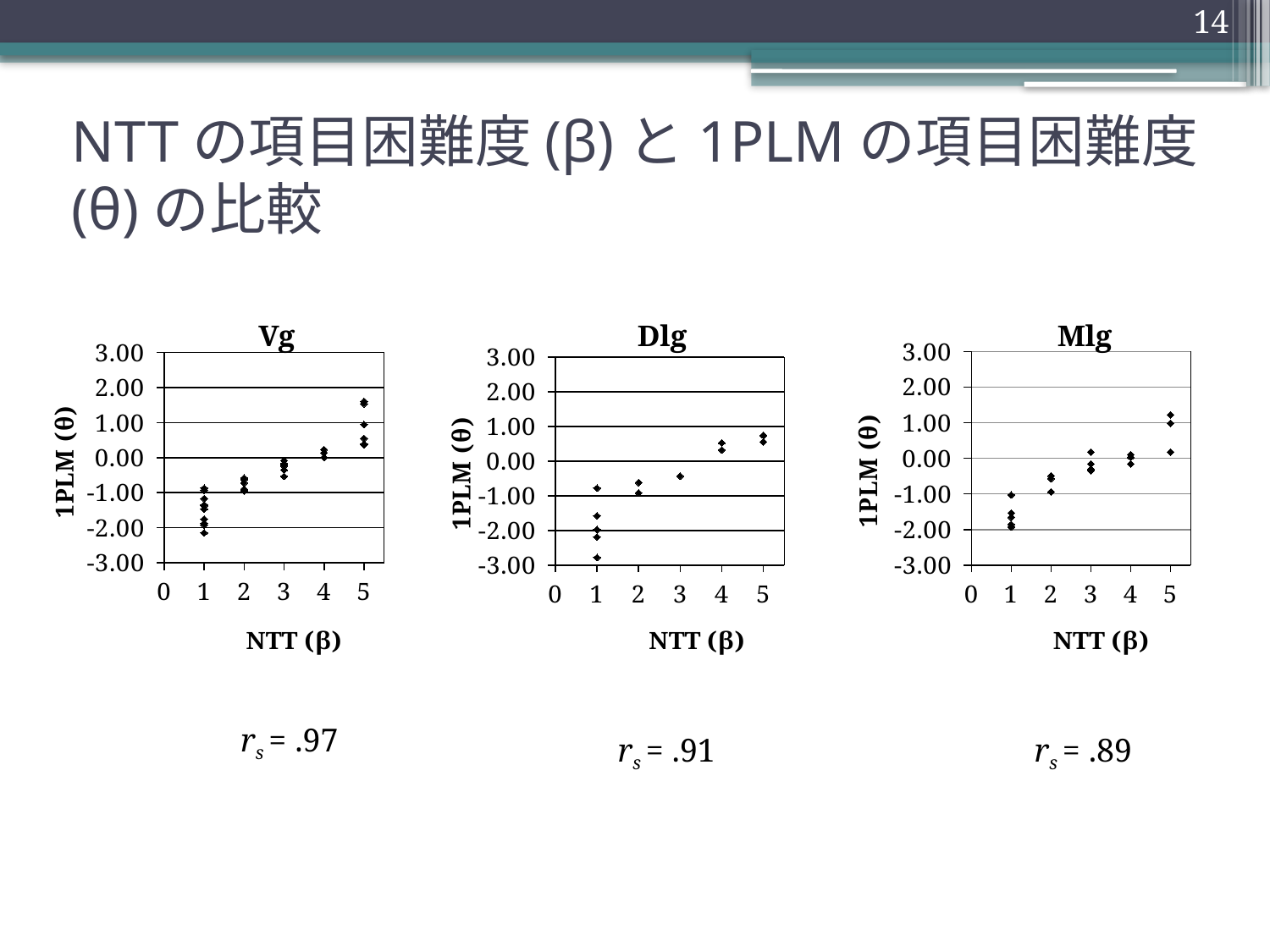
In the chart titled Dlg, are the 1PLM (θ) values for NTT (β) = 5 greater or less than 0.00? greater What is the label of the vertical axis in the chart titled Mlg? 1PLM (θ) In the chart titled Vg, are the 1PLM (θ) values for NTT (β) = 5 greater or less than 0.00? greater How many charts are shown on the slide? 3 What is the label of the horizontal axis in the chart titled Dlg? NTT (β) In the chart titled Mlg, are the 1PLM (θ) values for NTT (β) = 1 greater or less than 0.00? less In the chart titled Dlg, do the 1PLM (θ) values rise or fall as NTT (β) increases from 1 to 5? rise In the chart titled Vg, do the 1PLM (θ) values rise or fall as NTT (β) increases from 1 to 5? rise What kind of chart is the chart titled Vg? scatter chart In the chart titled Mlg, do the 1PLM (θ) values rise or fall as NTT (β) increases from 1 to 5? rise